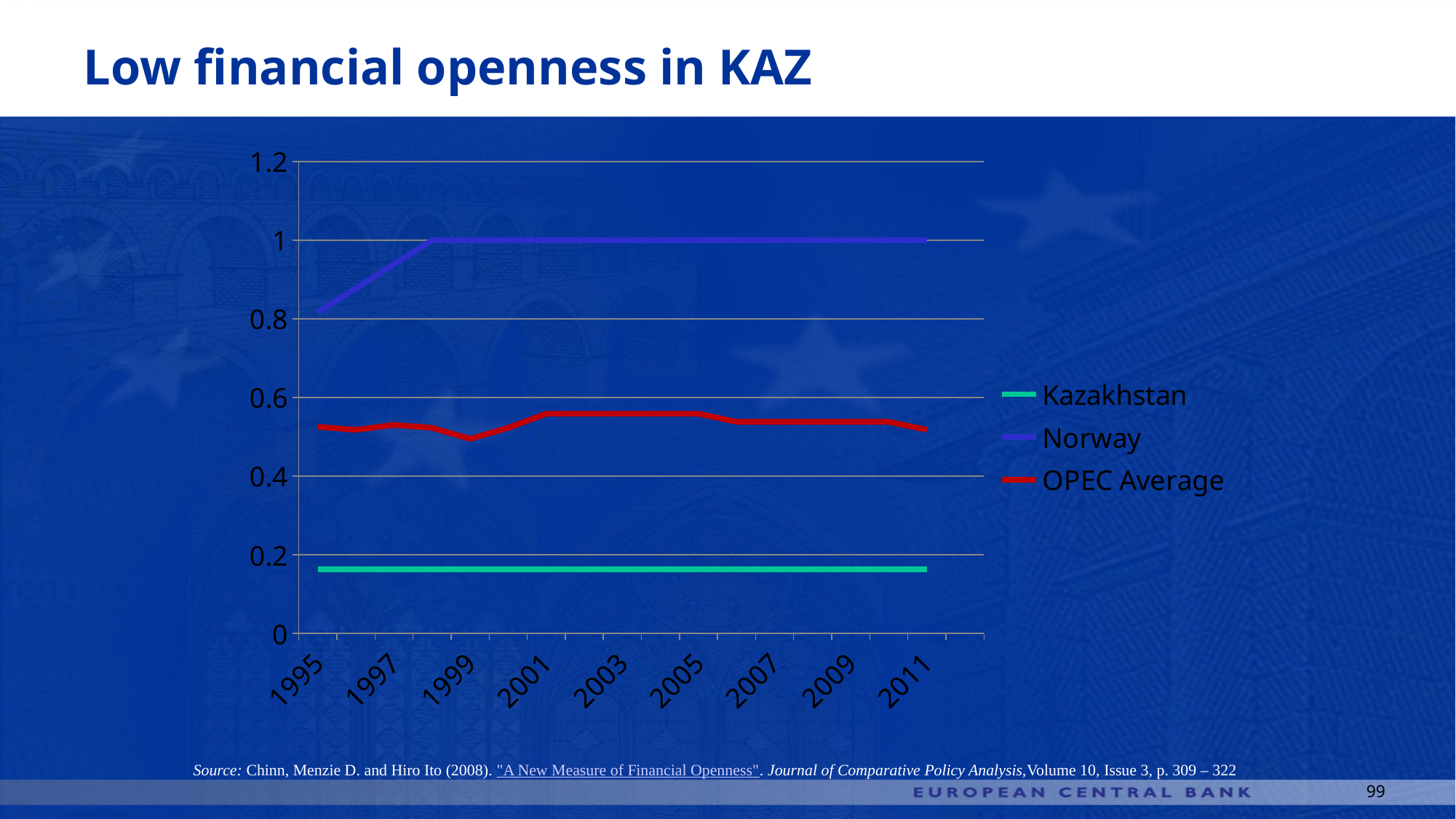
How many series does the legend list? 3 Which series does the legend list in red? OPEC Average Is the value for Norway in 1995 greater or less than 1? less What is the value for Norway in 2005? 1 Which series has the highest values across the chart? Norway Does the Norway line rise or fall between 1995 and 1999? rise What is the title of the slide containing the chart? Low financial openness in KAZ Which is larger in 2009, the value for Norway or the value for OPEC Average? Norway Is the value for Kazakhstan in 2005 greater or less than 0.2? less What kind of chart is shown on the slide? line chart Is the value for OPEC Average in 2003 greater or less than 0.4? greater Which series has the lowest values across the chart? Kazakhstan